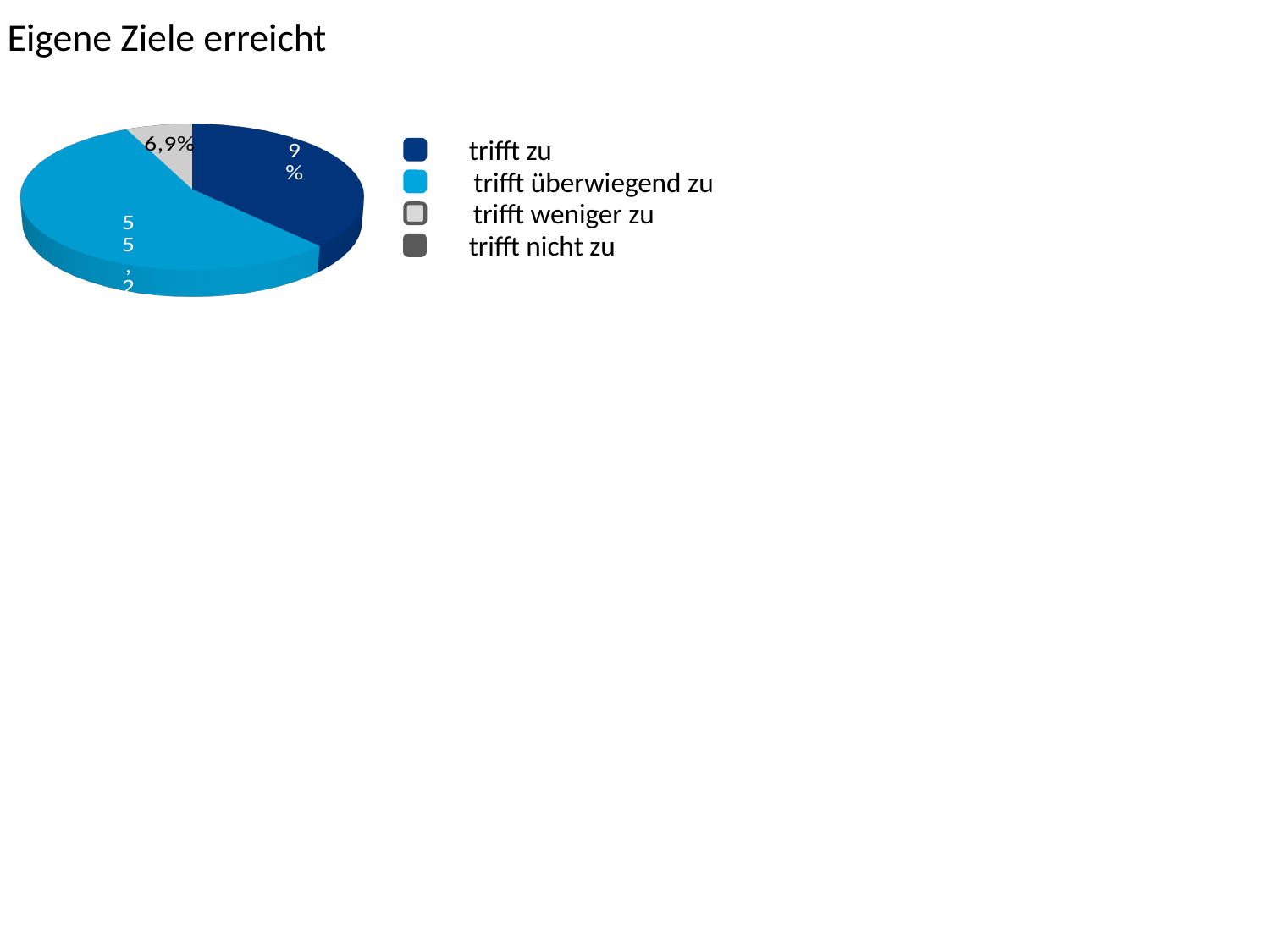
Does the 'trifft überwiegend zu' slice cover more or less than half of the pie? more What percentage is shown for the 'trifft weniger zu' slice? 6,9% What kind of chart is shown on the slide? pie chart What colour represents 'trifft zu' in the legend? dark blue How many entries does the legend list? 4 Which category has the largest slice of the pie? trifft überwiegend zu Which slice is larger, 'trifft zu' or 'trifft überwiegend zu'? trifft überwiegend zu Which slice is larger, 'trifft zu' or 'trifft weniger zu'? trifft zu What is the title of the chart? Eigene Ziele erreicht